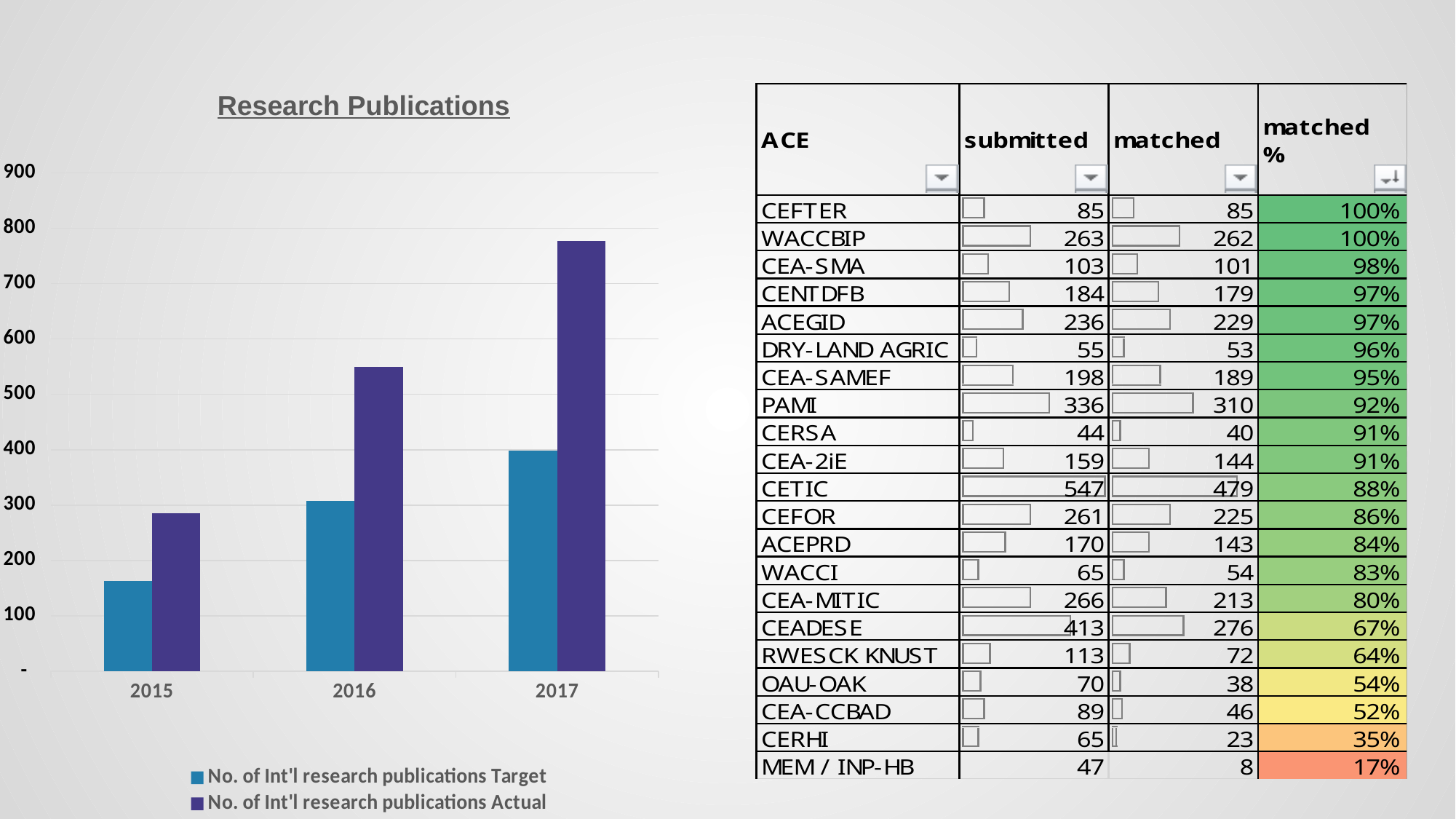
In the Research Publications chart, which year has the highest value for No. of Int'l research publications Actual? 2017 How many years are shown on the x axis of the Research Publications chart? 3 In the Research Publications chart, which is larger in 2016: the Target or the Actual number of publications? Actual In the Research Publications chart, is the 2015 value for No. of Int'l research publications Target greater or less than 200? less In the Research Publications chart, is the 2017 value for No. of Int'l research publications Target greater or less than 300? greater In the Research Publications chart, is the 2017 value for No. of Int'l research publications Actual greater or less than 700? greater How many series does the legend of the Research Publications chart list? 2 In the Research Publications chart, do the values for No. of Int'l research publications Actual rise or fall from 2015 to 2017? rise What type of chart is shown under the title "Research Publications"? bar chart What is the title of the chart on the left of the slide? Research Publications In the Research Publications chart, which year has the lowest value for No. of Int'l research publications Target? 2015